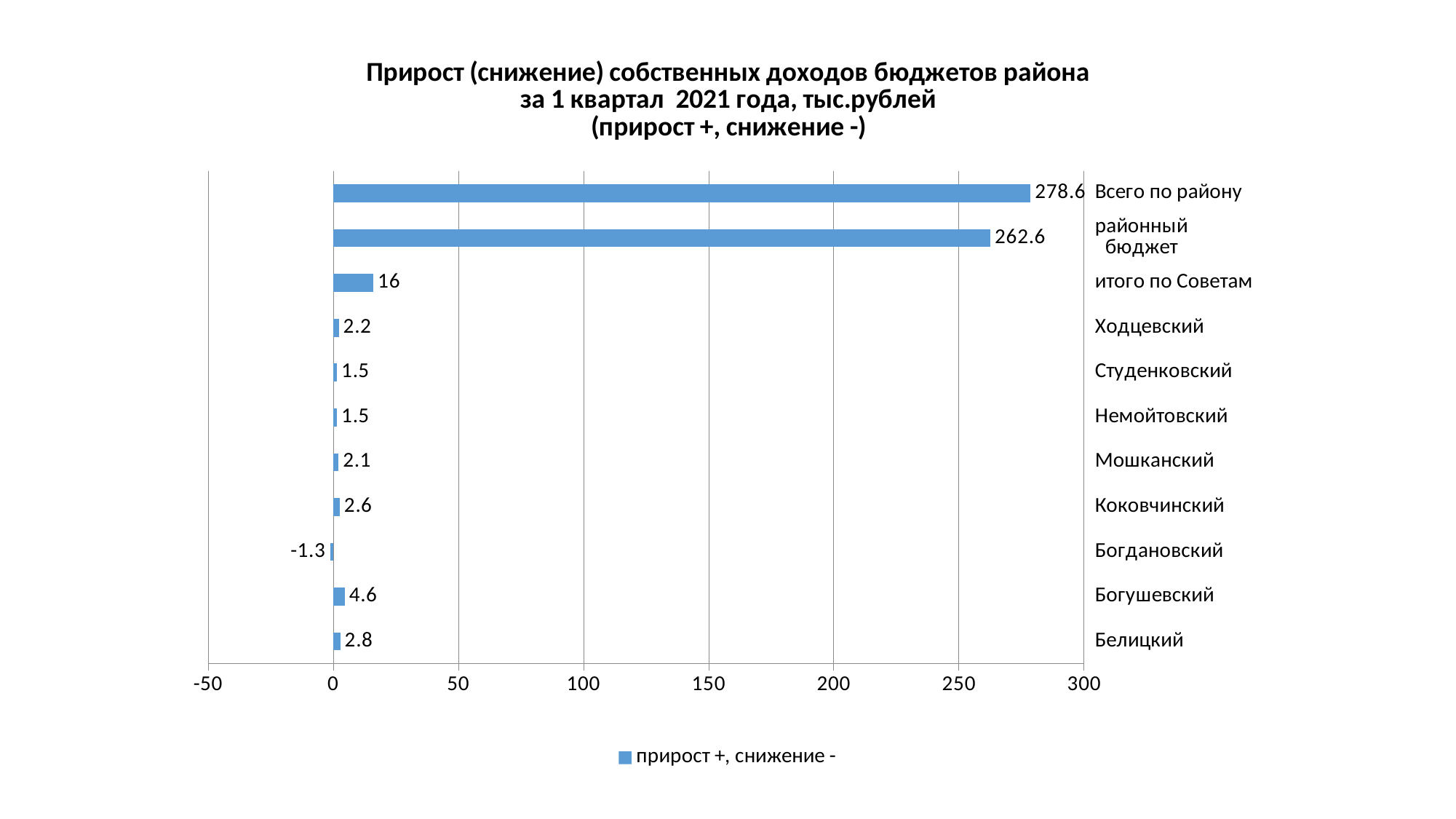
Which is larger, the value for Коковчинский or the value for Ходцевский? Коковчинский What is the legend entry shown below the chart? прирост +, снижение - What is the value for Всего по району? 278.6 What is the value for районный бюджет? 262.6 What is the difference between the values for Всего по району and районный бюджет? 16 What is the value for Богдановский? -1.3 How many categories are shown on the chart? 11 What is the value for Богушевский? 4.6 What is the value for итого по Советам? 16 Which category has the highest value? Всего по району What kind of chart is shown on the slide? Bar chart Which category has the lowest value? Богдановский